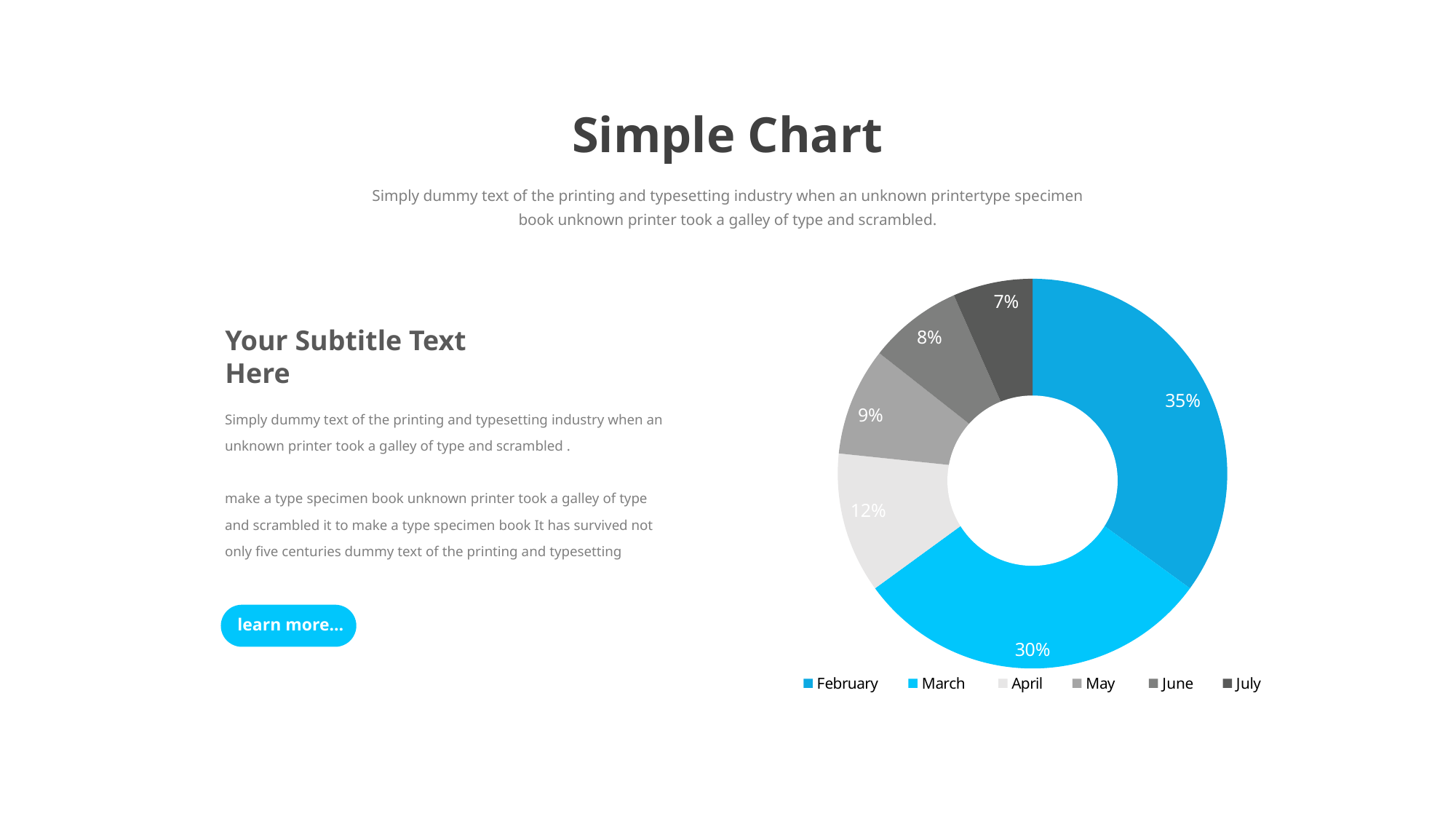
What percentage does the July slice show? 7% What is the difference between the February and March percentages? 5% How many slices does the chart have? 6 Which month has the smallest slice? July What percentage does the April slice show? 12% What percentage does the March slice show? 30% What is the combined share of the April and May slices? 21% What kind of chart is shown on the slide? Doughnut chart Which is larger, the May slice or the June slice? May What is the title of the slide containing the chart? Simple Chart Which month has the largest slice? February What percentage does the February slice show? 35%